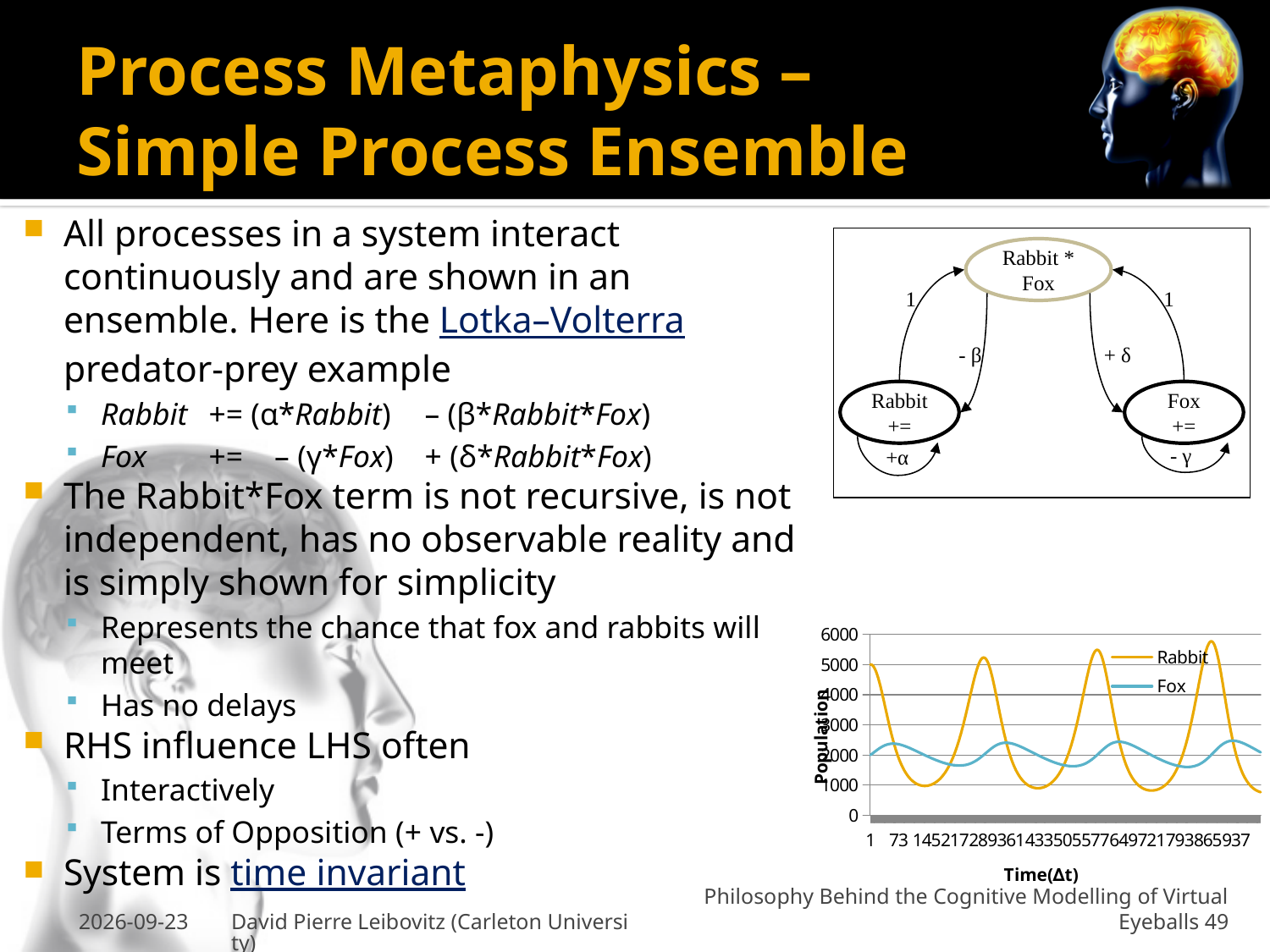
What is the label of the vertical axis of the line chart? Population In the line chart, is the highest value of the Fox series greater or less than 3000? less What is the label of the horizontal axis of the line chart? Time(Δt) What are the two series named in the legend of the line chart? Rabbit and Fox How many series does the legend of the Population vs Time chart list? 2 In the line chart, is the highest value of the Rabbit series greater or less than 4000? greater What kind of chart is shown at the bottom right of the slide? line chart In the line chart, is the highest value of the Fox series greater or less than 1000? greater In the line chart, which series reaches the higher peak values, Rabbit or Fox? Rabbit